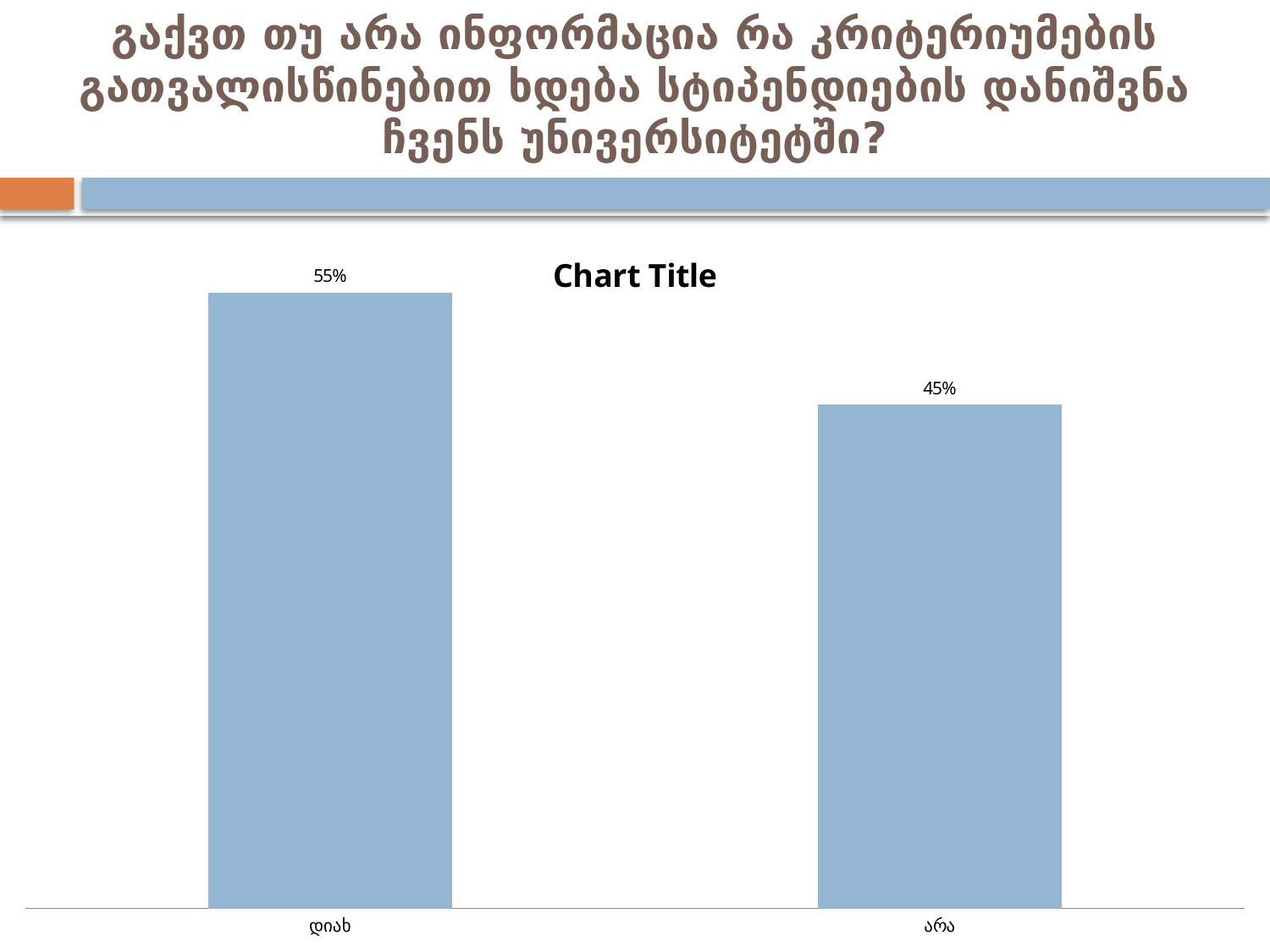
Which is larger, the value for დიახ or the value for არა? დიახ Do the values rise or fall from left to right along the x axis? fall What is the title shown above the chart? Chart Title What is the value for არა? 45% What is the value for დიახ? 55% Which category has the highest value? დიახ What kind of chart is shown on the slide? bar chart How many categories are shown in the chart? 2 What colour are the bars in the chart? light blue Which category has the lowest value? არა What is the difference between the values for დიახ and არა? 10%